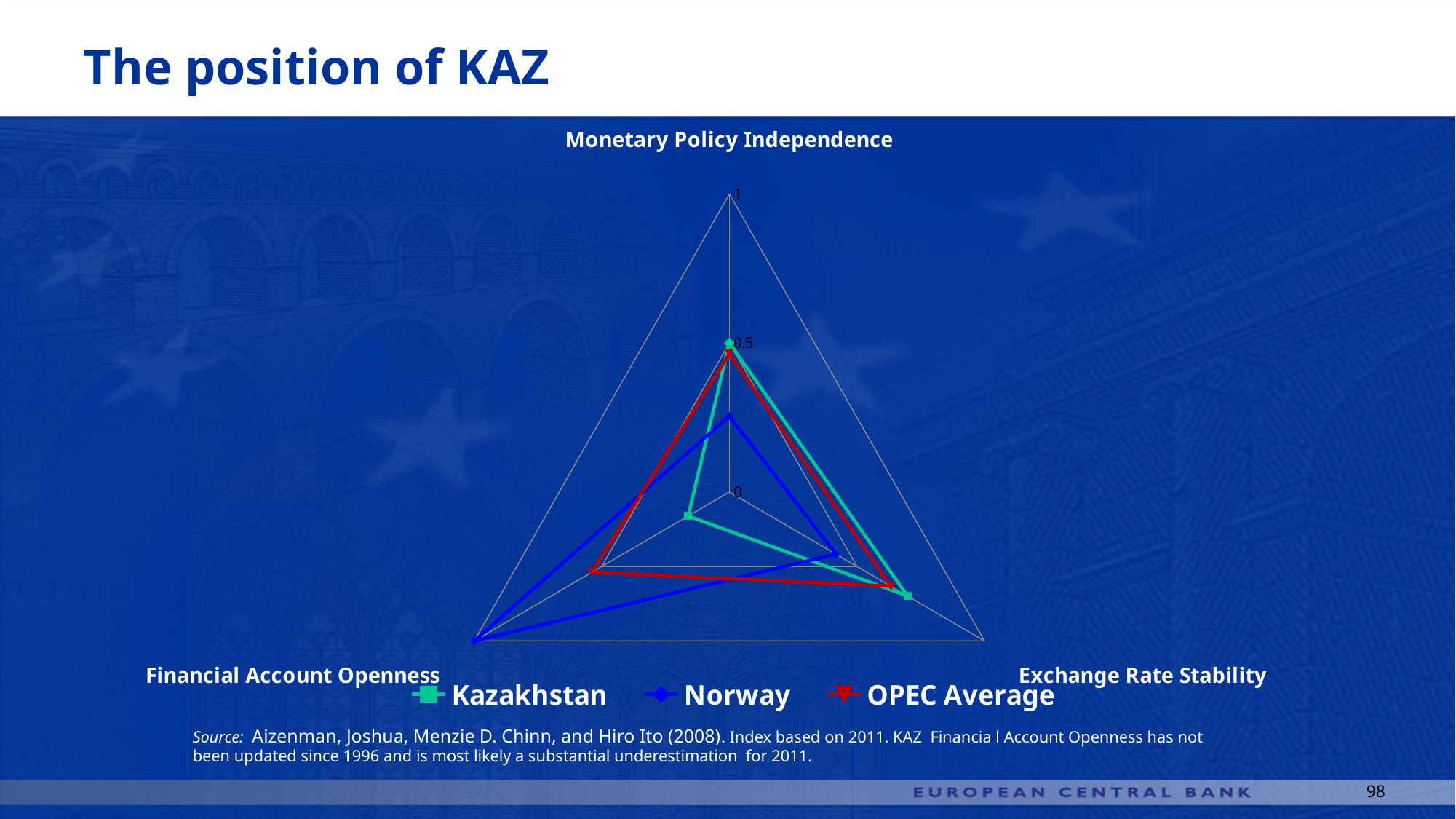
What colour is the Kazakhstan line in the chart? Green Which series has the highest value for Financial Account Openness? Norway How many series does the legend list? 3 What is Norway's value for Financial Account Openness? 1 How many axes (categories) does the radar chart have? 3 Is Kazakhstan's value for Exchange Rate Stability greater or less than 0.5? greater Is Kazakhstan's value for Financial Account Openness greater or less than 0.5? less What kind of chart is shown on the slide? Radar chart Which series has the lowest value for Monetary Policy Independence? Norway Is the OPEC Average value for Exchange Rate Stability greater or less than 0.5? greater Which has the higher Monetary Policy Independence, Kazakhstan or Norway? Kazakhstan